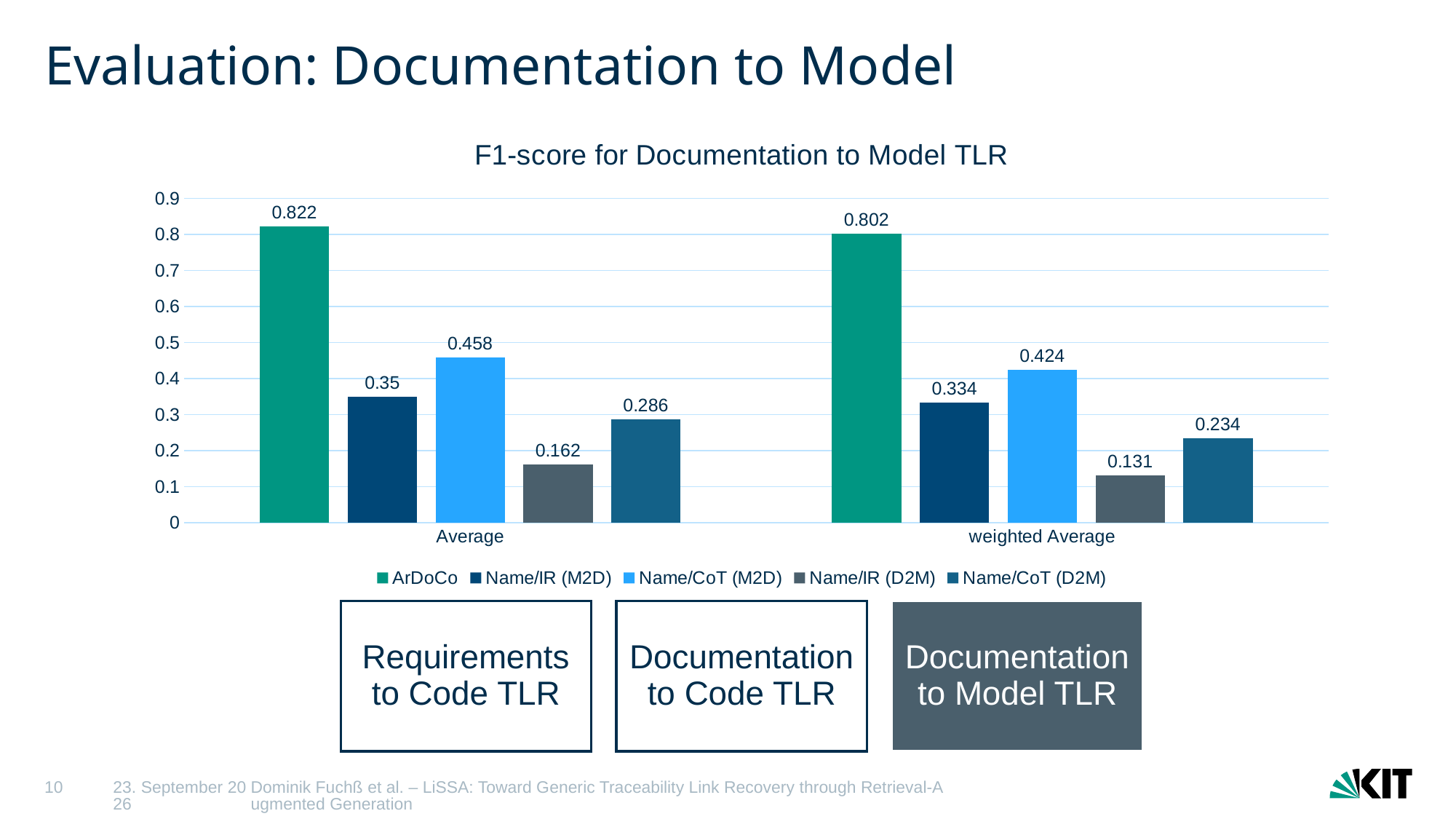
What is the F1-score for Name/IR (D2M) in the Average category? 0.162 Which is larger in the weighted Average category: Name/IR (M2D) or Name/CoT (D2M)? Name/IR (M2D) What is the title of the chart? F1-score for Documentation to Model TLR Which series has the highest F1-score in the weighted Average category? ArDoCo How many categories are shown on the x axis? 2 Which series has the lowest F1-score in the Average category? Name/IR (D2M) What is the difference between the ArDoCo F1-score for Average and for weighted Average? 0.02 What is the F1-score for Name/CoT (M2D) in the weighted Average category? 0.424 What is the difference between Name/CoT (M2D) and Name/IR (M2D) in the Average category? 0.108 Is the value for Name/CoT (D2M) in the Average category greater or less than 0.3? less What is the F1-score for ArDoCo in the Average category? 0.822 How many series does the legend list? 5